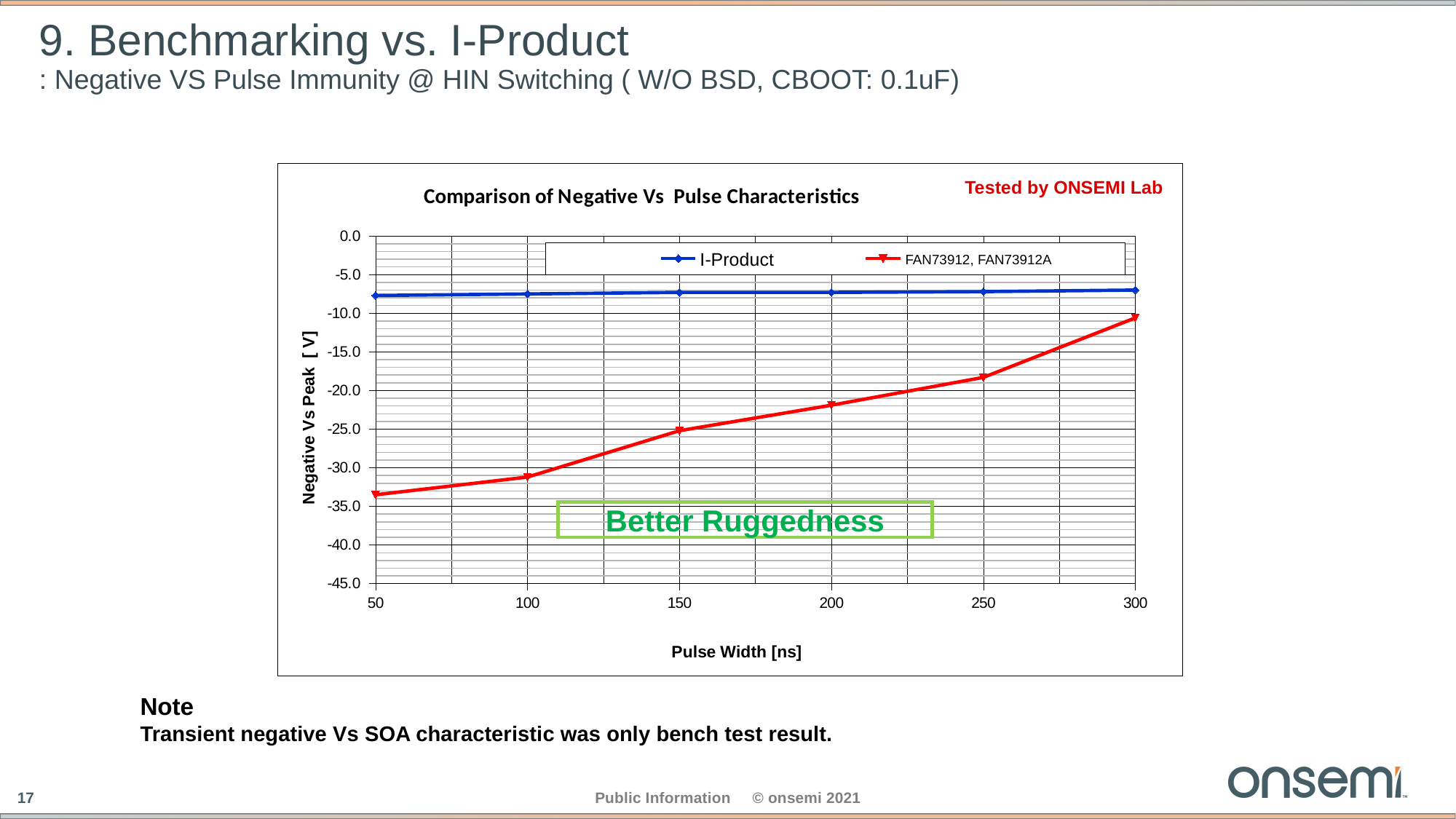
What kind of chart is shown on the slide? Line chart How many series does the chart legend list? 2 How many pulse width points are plotted for each series? 6 Which series stays nearly flat across the pulse width range? I-Product Is the value for FAN73912, FAN73912A at a pulse width of 50 ns greater or less than -30.0? less Is the value for I-Product at a pulse width of 50 ns greater or less than -10.0? greater What is the title of the chart? Comparison of Negative Vs Pulse Characteristics At a pulse width of 300 ns, which series has the more negative Negative Vs Peak value? FAN73912, FAN73912A Does the FAN73912, FAN73912A series rise or fall as pulse width increases from 50 ns to 300 ns? rise Is the value for FAN73912, FAN73912A at a pulse width of 250 ns greater or less than -20.0? greater What is the label of the x axis? Pulse Width [ns]